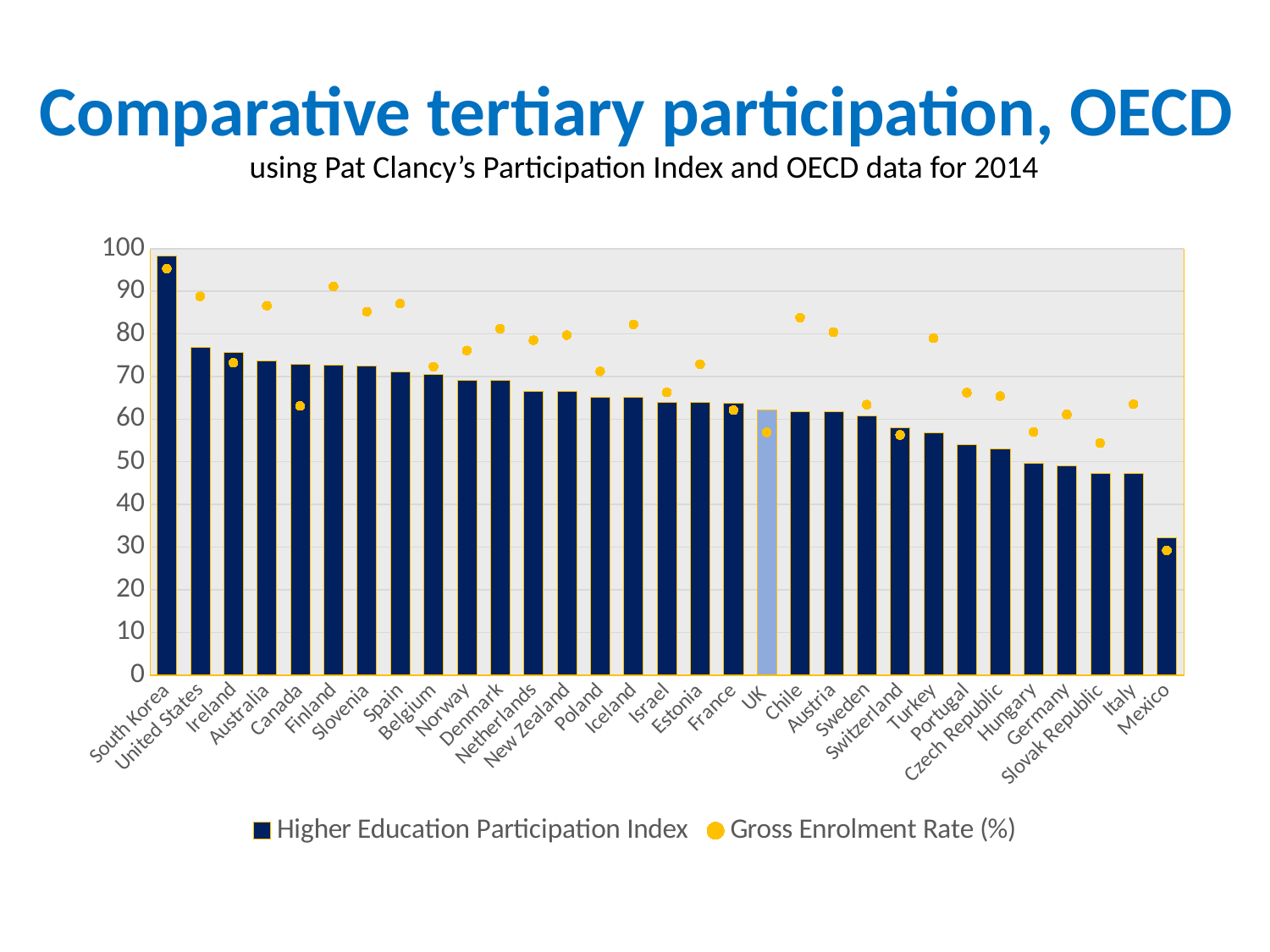
Is the Gross Enrolment Rate (%) for Canada greater or less than 70? less Is the Higher Education Participation Index for Mexico greater or less than 40? less How many countries are shown on the x axis? 31 Which country has the lowest Higher Education Participation Index bar? Mexico Which has the higher Gross Enrolment Rate (%), Canada or Finland? Finland Which country has the highest Higher Education Participation Index bar? South Korea Do the Higher Education Participation Index bars rise or fall from left to right along the x axis? fall How many series does the legend list? 2 What kind of chart is shown on the slide? bar chart (with a dot series overlaid) Is the Gross Enrolment Rate (%) for Finland greater or less than 80? greater Which country's bar is highlighted in a lighter blue colour than the others? UK